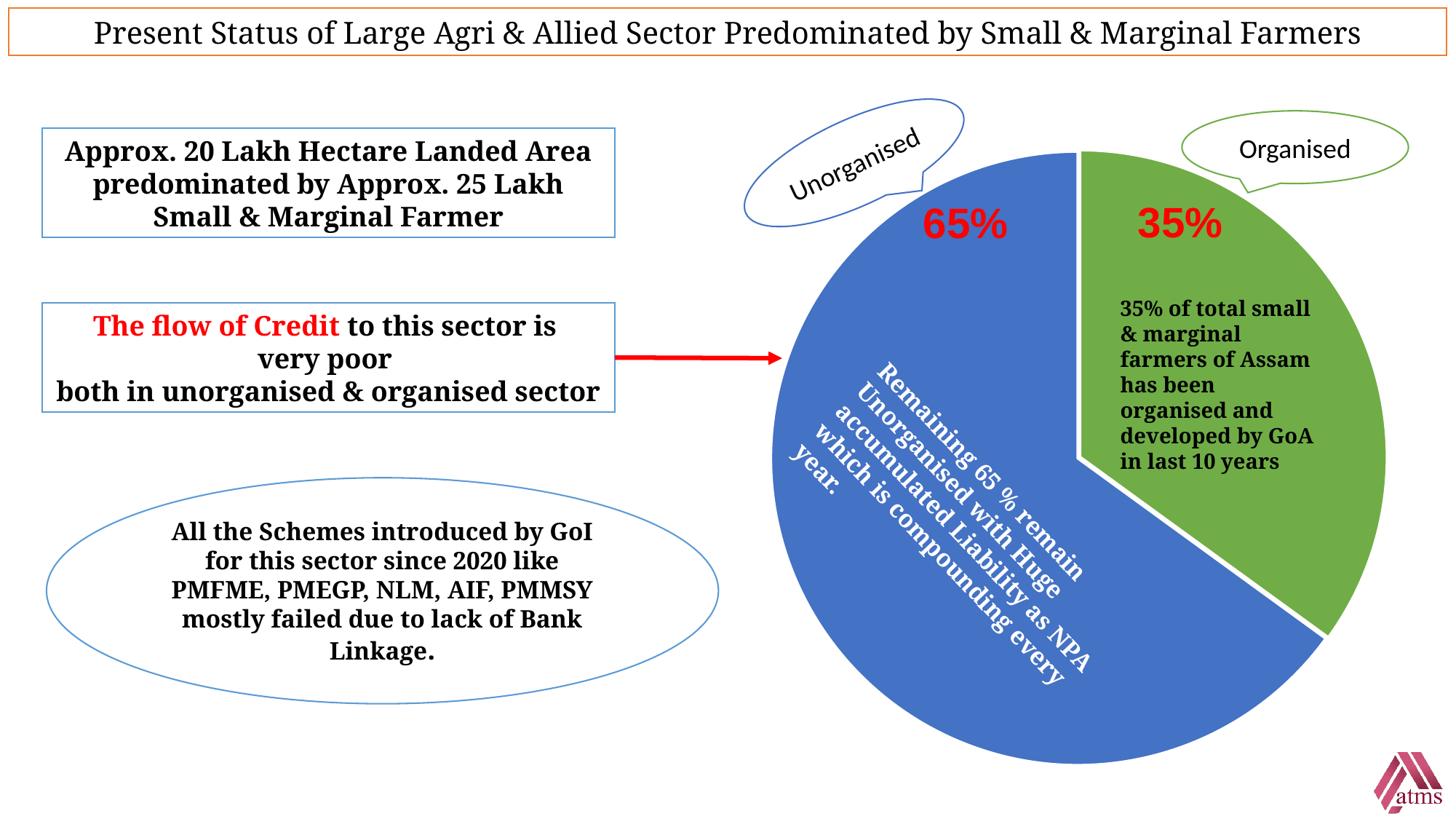
Which slice is the largest in the pie chart? Unorganised What is the difference in percentage points between the Unorganised and Organised slices? 30 What share of the pie does the Organised slice represent? 35% How many slices does the pie chart have? 2 What colour is the Unorganised slice? blue What colour is the Organised slice? green Which slice is the smallest in the pie chart? Organised Which is larger, the Unorganised slice or the Organised slice? Unorganised What percentage does the Organised slice show? 35% What percentage does the Unorganised slice show? 65% What kind of chart is shown on the slide? pie chart